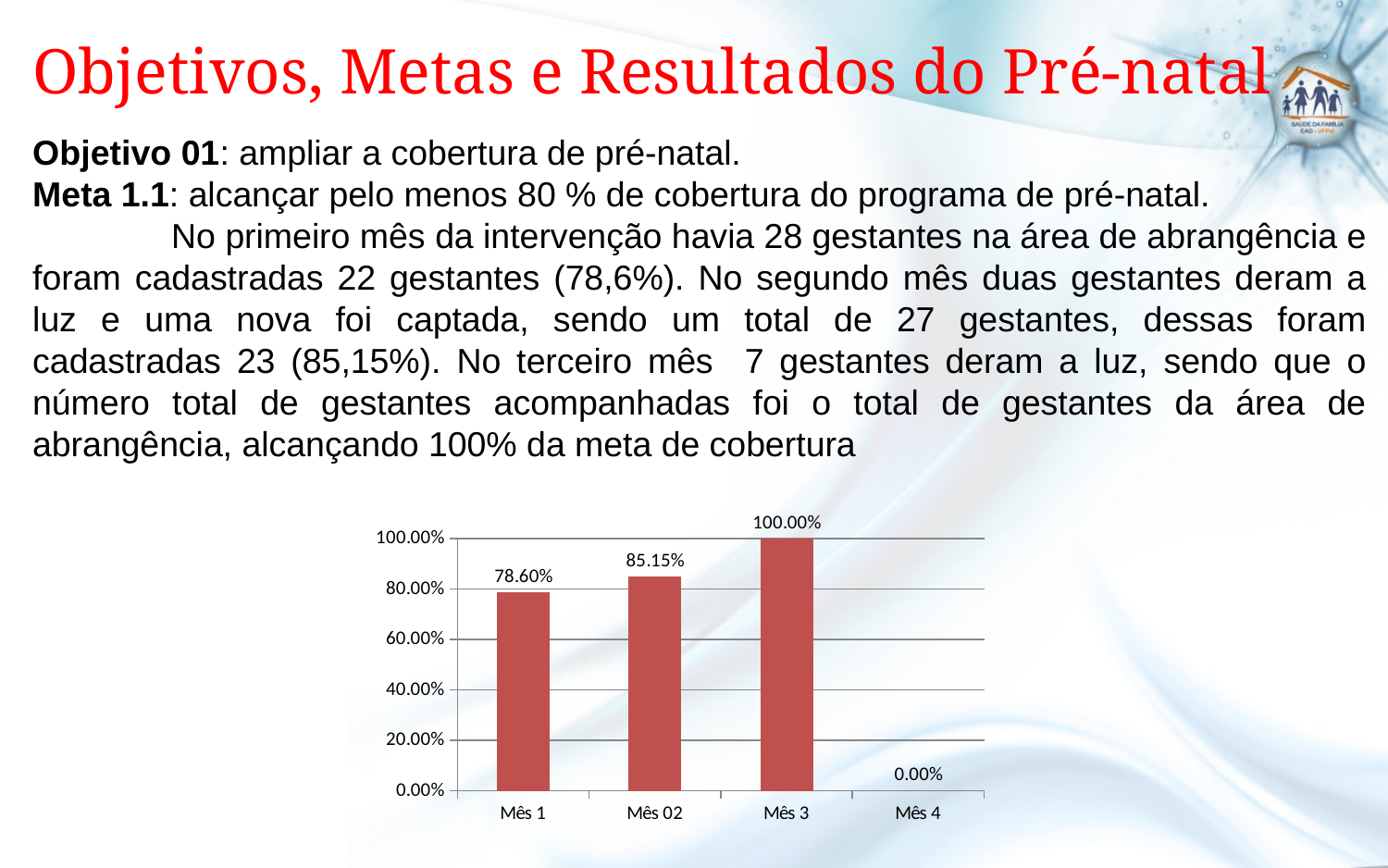
What is the value for Mês 4? 0.00% Which category has the highest value? Mês 3 What is the difference between the values for Mês 3 and Mês 1? 21.40% Is the value for Mês 1 greater or less than 80.00%? less What is the value for Mês 1? 78.60% What is the value for Mês 02? 85.15% What kind of chart is shown on the slide? bar chart Which is larger, the value for Mês 02 or the value for Mês 1? Mês 02 Which category has the lowest value? Mês 4 What is the difference between the values for Mês 02 and Mês 1? 6.55% How many categories are shown on the x axis? 4 What is the value for Mês 3? 100.00%